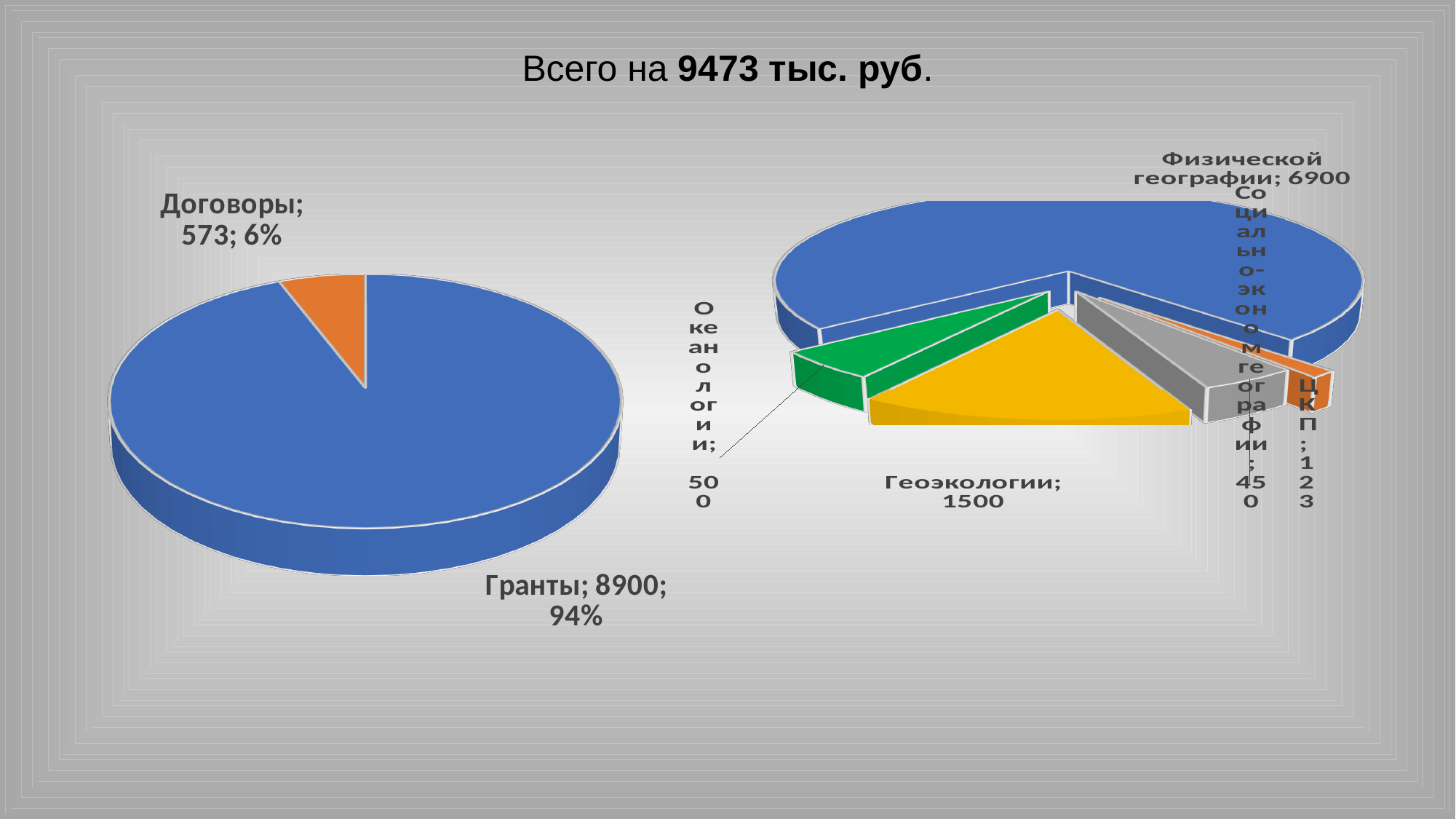
In the right pie chart, what value is shown for Физической географии? 6900 In the right pie chart, which category has the smallest value? ЦКП In the right pie chart, which is larger: Океанологии or Социально-экономической географии? Океанологии How many slices does the left pie chart have? 2 How many slices does the right pie chart have? 5 In the left pie chart, what is the difference between the values for Гранты and Договоры? 8327 What total amount is stated in the slide title? 9473 тыс. руб. What type of chart is the left chart on the slide? pie chart In the right pie chart, what value is shown for Геоэкологии? 1500 In the left pie chart, what value is shown for Договоры? 573 In the left pie chart, what percentage share does Гранты have? 94% In the left pie chart, which category is the largest? Гранты